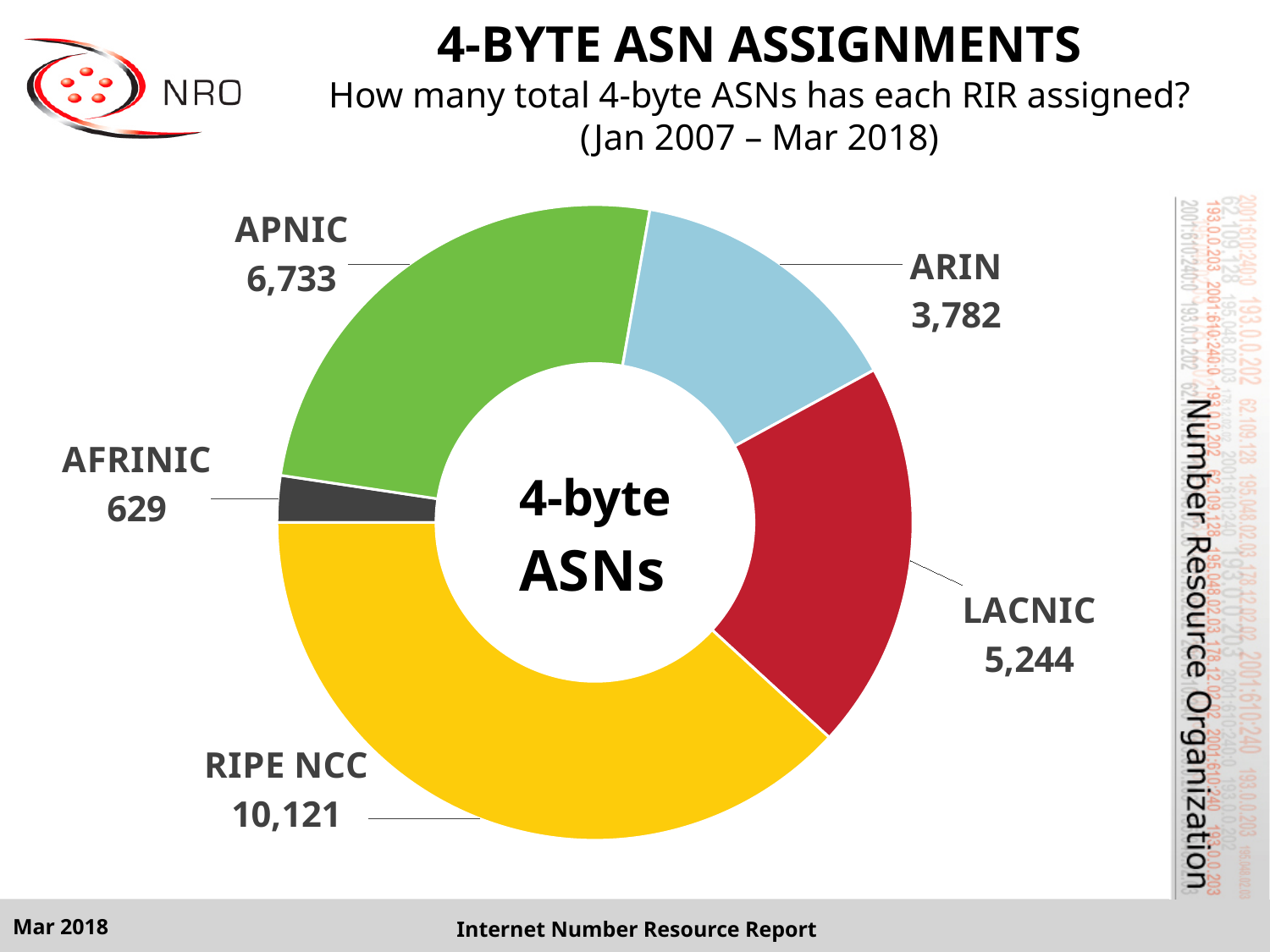
What kind of chart is shown on the slide? Donut (pie) chart How many 4-byte ASNs has RIPE NCC assigned? 10,121 What is the value shown for LACNIC? 5,244 Which RIR has assigned the most 4-byte ASNs? RIPE NCC What colour is the RIPE NCC segment of the chart? Yellow How many 4-byte ASNs has AFRINIC assigned? 629 What is the difference between the LACNIC and ARIN values? 1,462 How many more 4-byte ASNs has RIPE NCC assigned than APNIC? 3,388 What is the value shown for APNIC? 6,733 Which RIR has assigned the fewest 4-byte ASNs? AFRINIC Which has assigned more 4-byte ASNs, ARIN or LACNIC? LACNIC How many RIRs are shown in the chart? 5